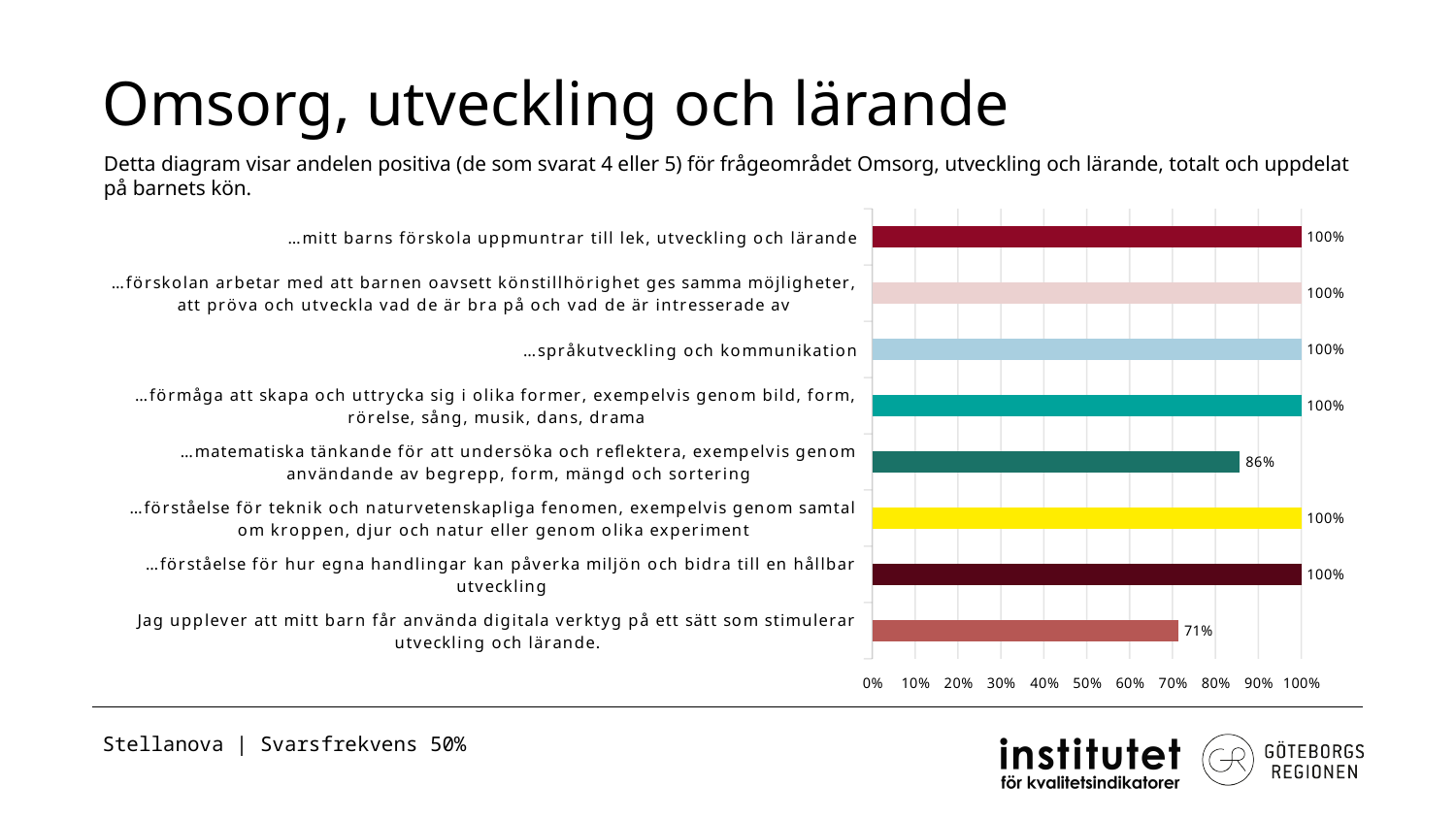
What is the difference between the value for "…matematiska tänkande…" and the value for "Jag upplever att mitt barn får använda digitala verktyg…"? 15% What is the value for "…språkutveckling och kommunikation"? 100% What is the difference between the value for "…språkutveckling och kommunikation" and the value for "…matematiska tänkande…"? 14% Which is larger: the value for "…matematiska tänkande…" or the value for "Jag upplever att mitt barn får använda digitala verktyg…"? …matematiska tänkande… What kind of chart is shown on the slide? bar chart What is the value for "Jag upplever att mitt barn får använda digitala verktyg på ett sätt som stimulerar utveckling och lärande."? 71% Which category has the lowest value? Jag upplever att mitt barn får använda digitala verktyg på ett sätt som stimulerar utveckling och lärande. How many categories are shown in the chart? 8 What is the value for "…matematiska tänkande för att undersöka och reflektera, exempelvis genom användande av begrepp, form, mängd och sortering"? 86% What is the value for "…förståelse för teknik och naturvetenskapliga fenomen, exempelvis genom samtal om kroppen, djur och natur eller genom olika experiment"? 100% Is the value for "Jag upplever att mitt barn får använda digitala verktyg…" greater or less than 80%? less How many categories have a value of 100%? 6